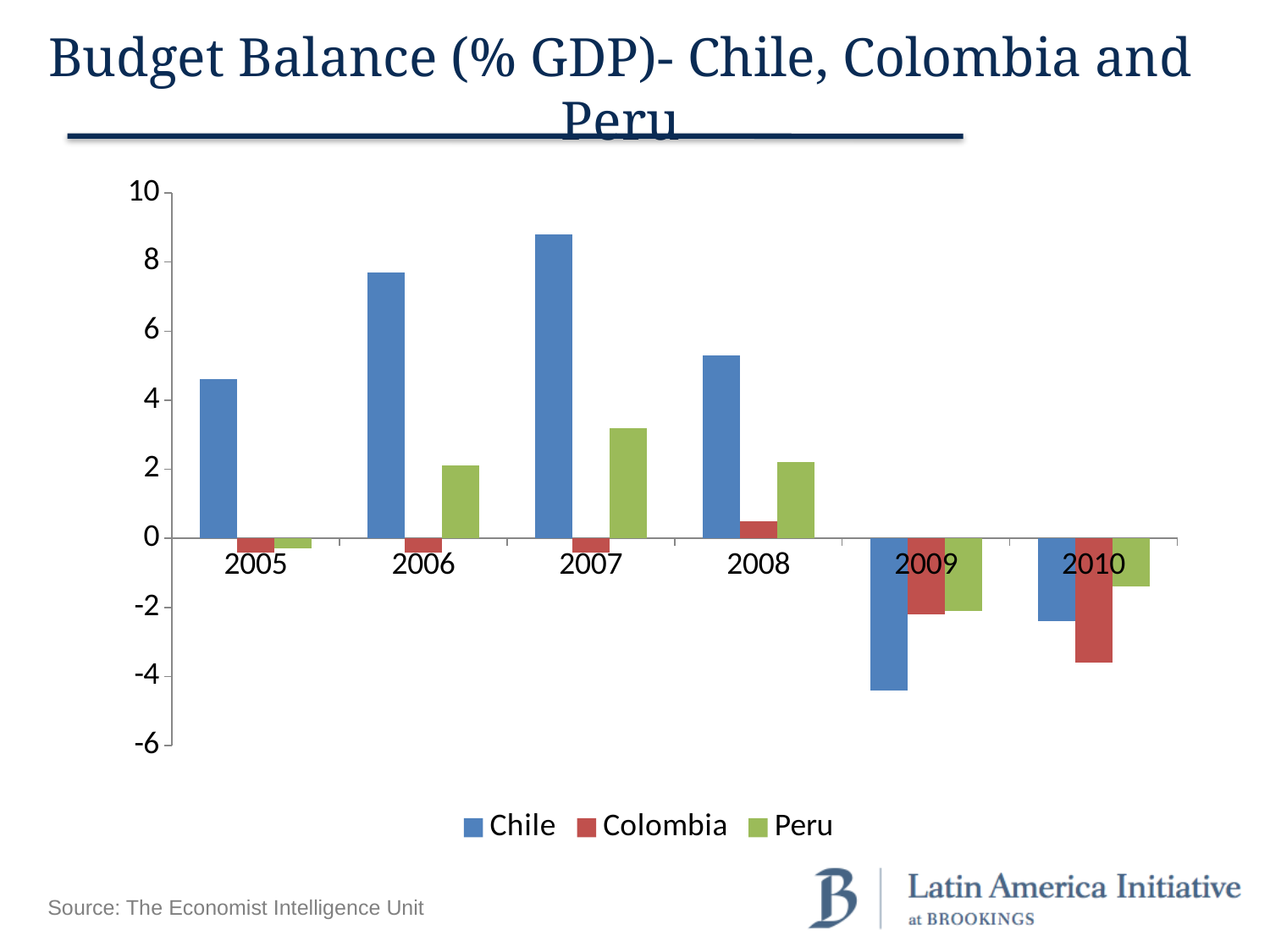
Is the value for Chile in 2009 greater or less than -2? less In 2008, which is larger, the value for Chile or the value for Peru? Chile Is the value for Chile in 2007 greater or less than 8? greater In 2010, which is larger, the value for Colombia or the value for Peru? Peru In which year is Colombia's budget balance lowest? 2010 In which year is Peru's budget balance highest? 2007 Is the value for Chile in 2006 greater or less than 6? greater What kind of chart is shown on the slide? Bar chart In which year is Chile's budget balance lowest? 2009 How many years are shown on the x axis? 6 How many series does the legend list? 3 In which year is Chile's budget balance highest? 2007